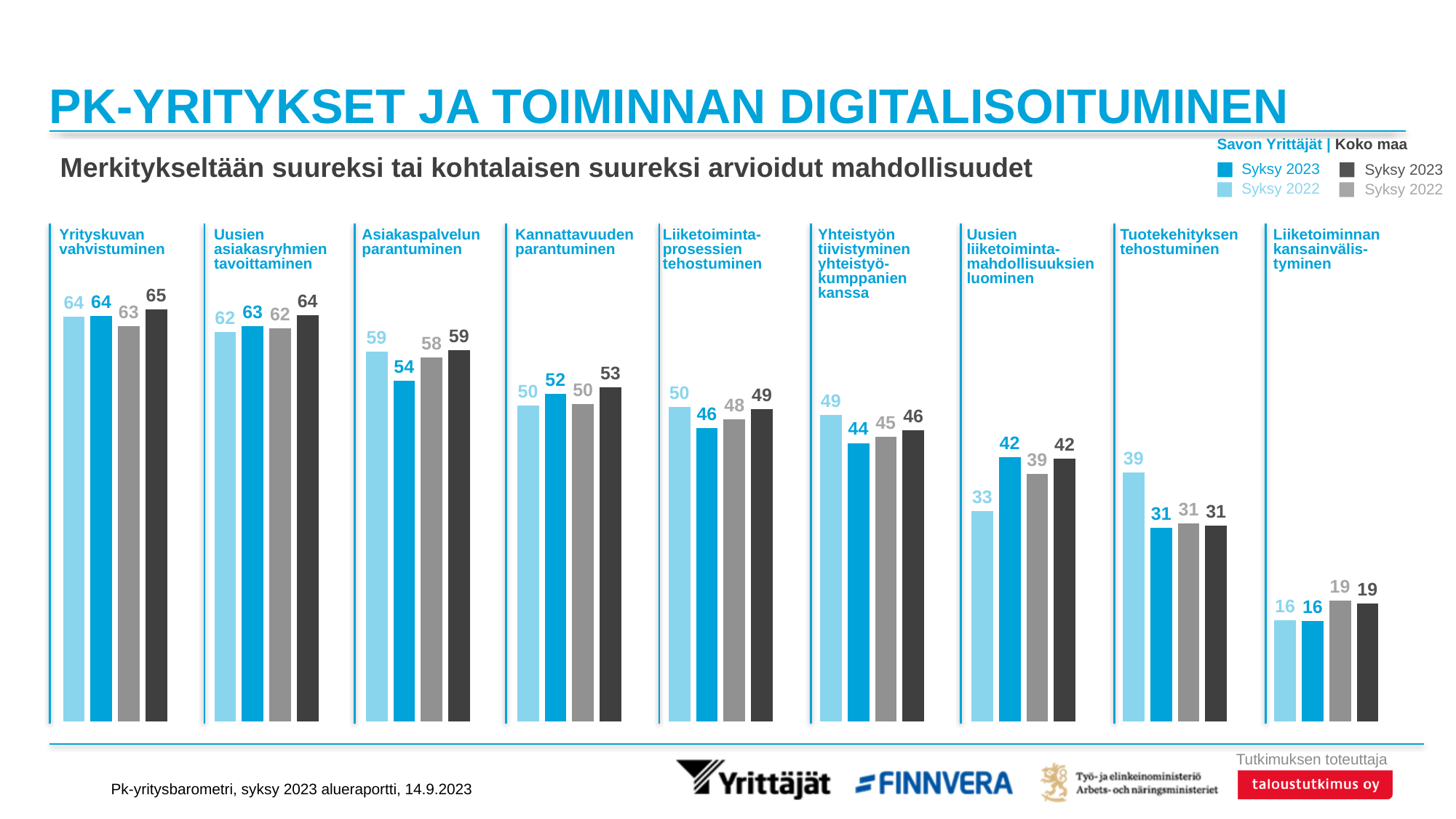
What is the Savon Yrittäjät Syksy 2022 value for Tuotekehityksen tehostuminen? 39 Which category has the lowest Koko maa Syksy 2023 value? Liiketoiminnan kansainvälistyminen What is the Savon Yrittäjät Syksy 2023 value for Yrityskuvan vahvistuminen? 64 What is the Koko maa Syksy 2023 value for Asiakaspalvelun parantuminen? 59 What is the difference between the Savon Yrittäjät Syksy 2023 and Savon Yrittäjät Syksy 2022 values for Uusien liiketoimintamahdollisuuksien luominen? 9 How many categories are shown in the chart? 9 How many series does the legend list? 4 What kind of chart is shown on the slide? Bar chart What is the difference between the Koko maa Syksy 2023 and Savon Yrittäjät Syksy 2023 values for Liiketoiminnan kansainvälistyminen? 3 Which category has the highest Savon Yrittäjät Syksy 2023 value? Yrityskuvan vahvistuminen What is the Koko maa Syksy 2022 value for Uusien liiketoimintamahdollisuuksien luominen? 39 For Liiketoimintaprosessien tehostuminen, which is larger: the Savon Yrittäjät Syksy 2023 value or the Koko maa Syksy 2023 value? Koko maa Syksy 2023